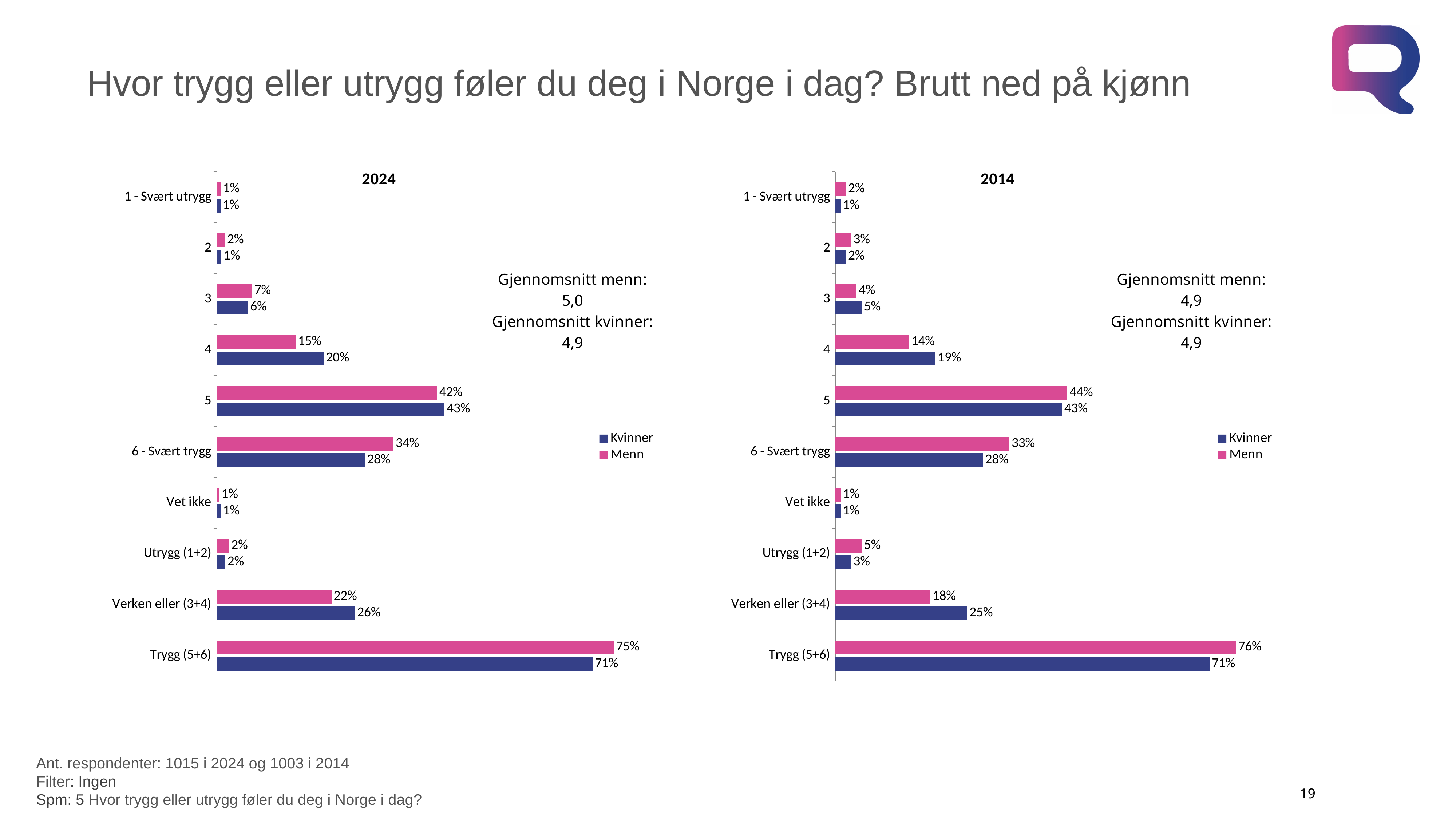
In the 2024 chart, what is the value for Kvinner in the category Trygg (5+6)? 71% In the 2014 chart, what is the value for Kvinner in the category 4? 19% In the 2024 chart, what is the difference between Menn and Kvinner in the category Trygg (5+6)? 4% How many categories are shown in the 2014 chart? 10 What kind of chart is the 2024 chart? Bar chart In the 2014 chart, what is the difference between Kvinner and Menn in the category Verken eller (3+4)? 7% How many series does the legend of the 2024 chart list? 2 In the 2014 chart, what is the value for Menn in the category Verken eller (3+4)? 18% In the 2024 chart, what is the value for Menn in the category 6 - Svært trygg? 34% In the 2024 chart, which category has the highest value for Menn? Trygg (5+6) In the 2024 chart, which is larger in the category 4: Kvinner or Menn? Kvinner In the 2014 chart, which is larger in the category 6 - Svært trygg: Kvinner or Menn? Menn